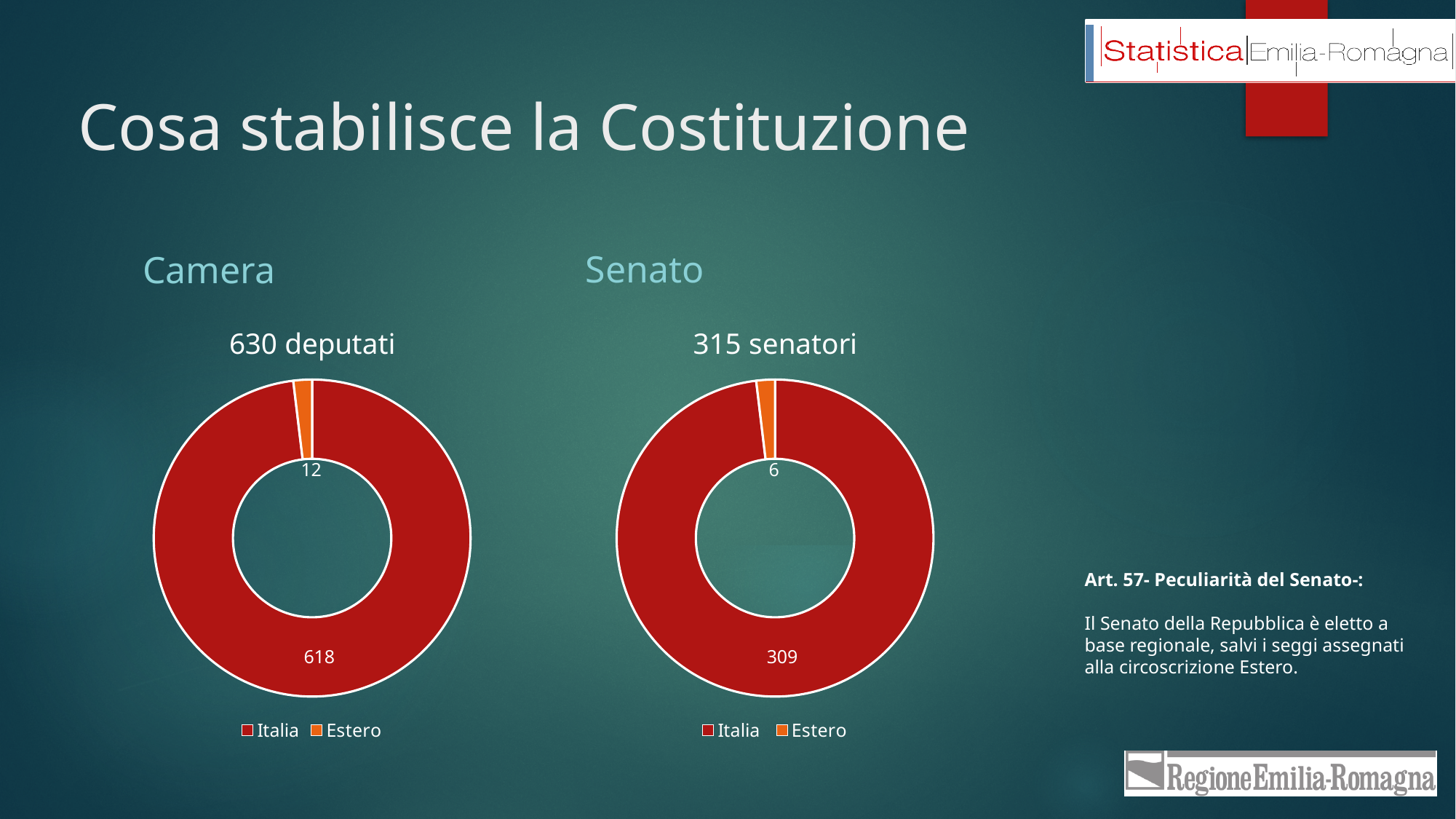
How many categories does the legend of the '630 deputati' chart list? 2 In the '630 deputati' chart, which category has the largest slice? Italia In the '630 deputati' chart, what is the difference between the Italia and Estero values? 606 In the '315 senatori' chart, what is the value for Italia? 309 Which is larger: the Estero value in the '630 deputati' chart or the Estero value in the '315 senatori' chart? 630 deputati (12) In the '315 senatori' chart, what is the difference between the Italia and Estero values? 303 In the '630 deputati' chart, what is the value for Estero? 12 In the '630 deputati' chart, what is the value for Italia? 618 In the '315 senatori' chart, what is the value for Estero? 6 In the '315 senatori' chart, what colour is the Estero slice? Orange What kind of chart is the '315 senatori' chart? Doughnut (pie) chart In the '315 senatori' chart, which category has the smallest slice? Estero